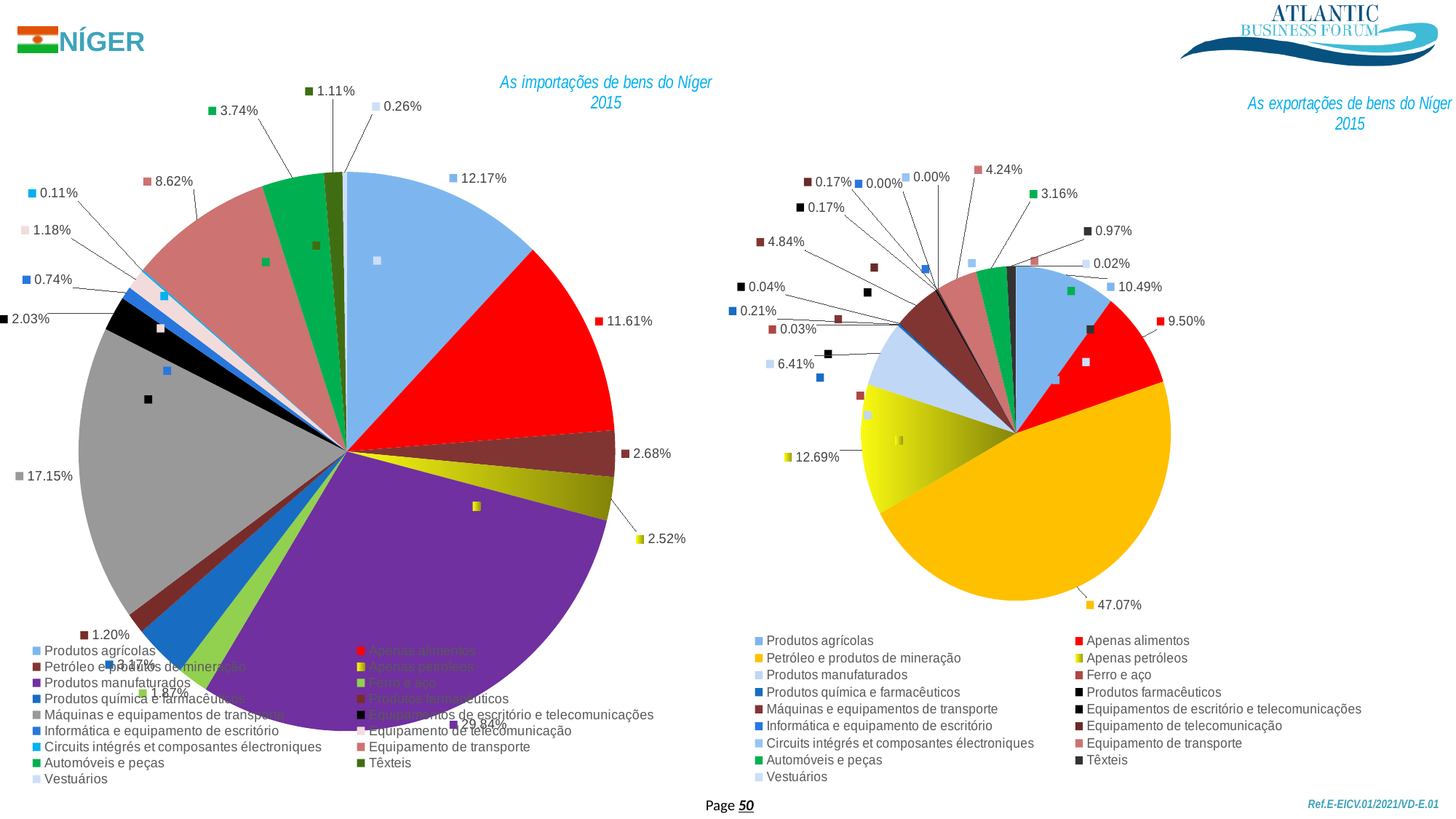
In the exports chart (right), what share is shown for Petróleo e produtos de mineração? 47.07% What type of chart is used for 'As importações de bens do Níger 2015'? pie chart How many categories does the legend of the exports chart (right) list? 17 In the imports chart (left), what is the difference between the shares of Produtos agrícolas and Apenas alimentos? 0.56% In the imports chart (left), what share is shown for Máquinas e equipamentos de transporte? 17.15% In the exports chart (right), what share is shown for Apenas petróleos? 12.69% In the exports chart (right), which category has the largest slice? Petróleo e produtos de mineração In the imports chart (left), which is larger: Equipamento de transporte or Automóveis e peças? Equipamento de transporte In the imports chart (left), which category has the largest slice? Produtos manufaturados What is the title of the chart on the right? As exportações de bens do Níger 2015 In the exports chart (right), what is the difference between the shares of Produtos agrícolas and Apenas alimentos? 0.99% In the imports chart (left), what share is shown for Produtos manufaturados? 29.84%